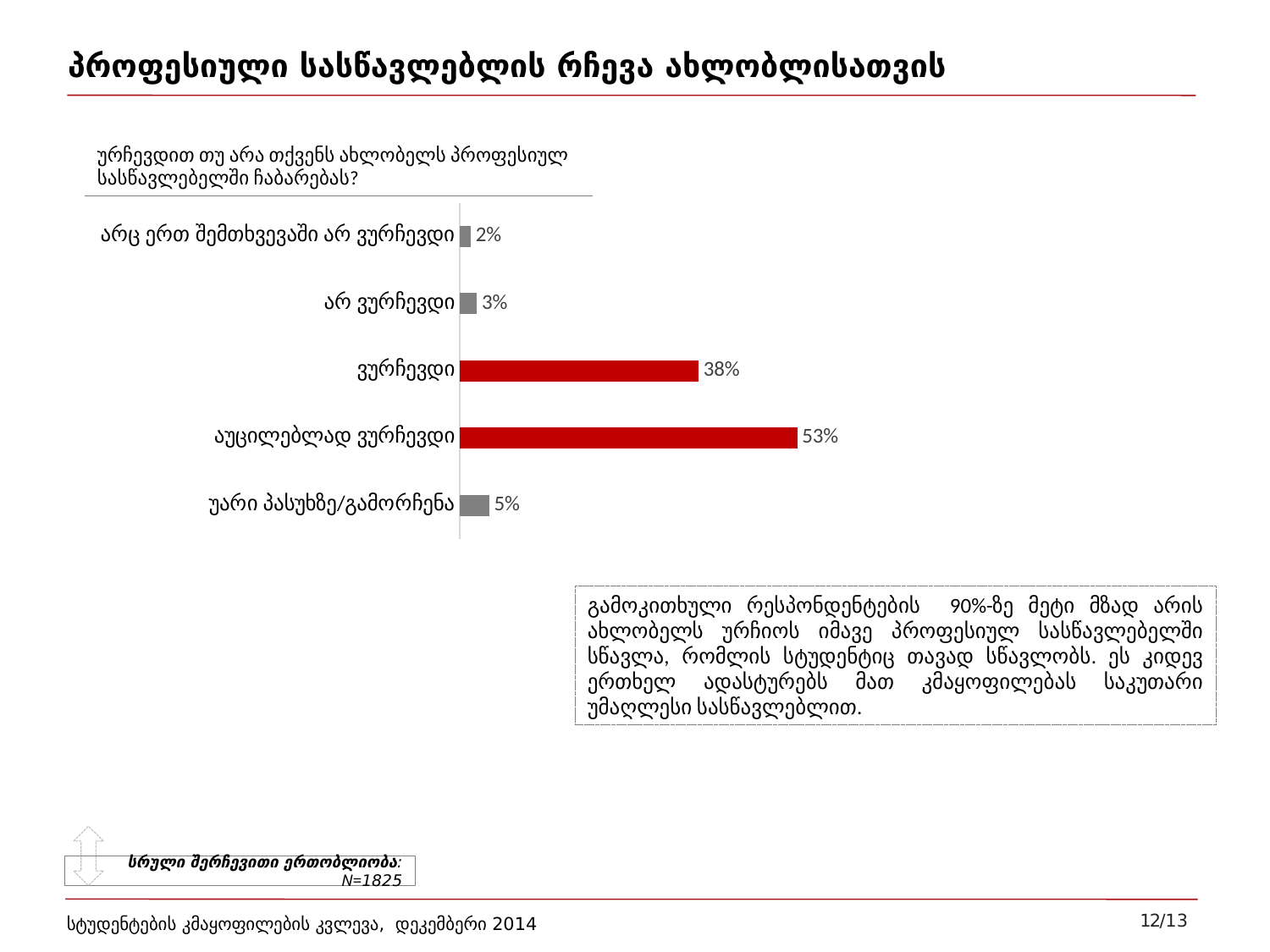
What colour are the bars for "ვურჩევდი" and "აუცილებლად ვურჩევდი"? Red What kind of chart is shown on the slide? Bar chart What is the difference between the values for "აუცილებლად ვურჩევდი" and "ვურჩევდი"? 15% What is the value for "უარი პასუხზე/გამორჩენა"? 5% Which is larger, the value for "უარი პასუხზე/გამორჩენა" or the value for "არ ვურჩევდი"? უარი პასუხზე/გამორჩენა How many categories are shown in the chart? 5 What is the value for "აუცილებლად ვურჩევდი"? 53% Which category has the highest value? აუცილებლად ვურჩევდი What is the value for "ვურჩევდი"? 38% What is the value for "არ ვურჩევდი"? 3% What is the combined value of "ვურჩევდი" and "აუცილებლად ვურჩევდი"? 91% Which category has the lowest value? არც ერთ შემთხვევაში არ ვურჩევდი